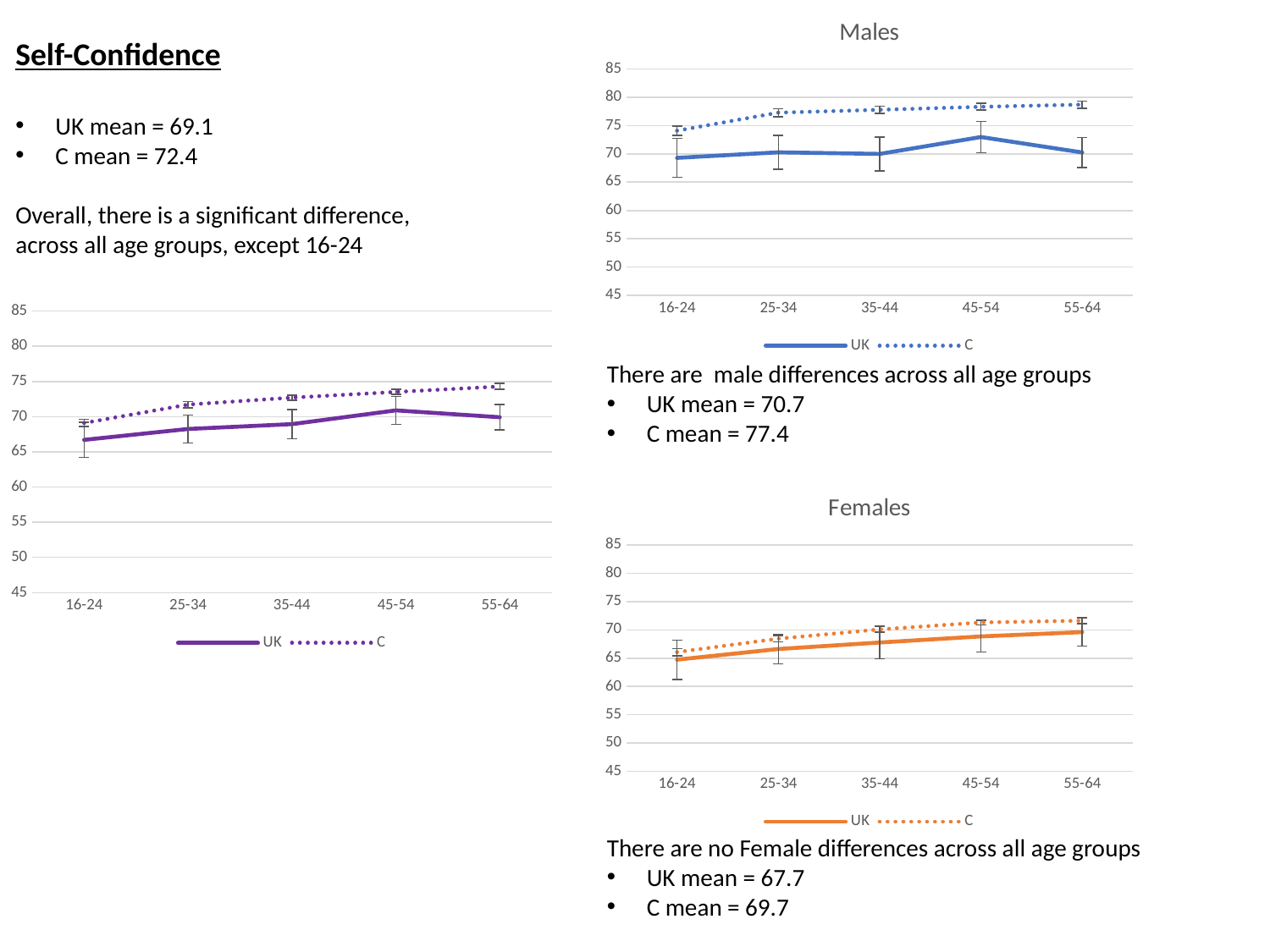
In the chart on the left of the slide, which series has the larger value at 16-24, UK or C? C In the chart titled "Males", which series is drawn with a dotted line? C In the chart titled "Females", does the C series rise or fall from 16-24 to 55-64? rise In the chart titled "Males", is the value for the C series at 55-64 greater or less than 75? greater In the chart on the left of the slide, which age group has the highest value for the UK series? 45-54 How many series does the legend of the chart on the left of the slide list? 2 How many age-group categories are shown on the x axis of the chart titled "Females"? 5 In the chart titled "Females", is the value for the UK series at 16-24 greater or less than 70? less In the chart titled "Males", which age group has the highest value for the UK series? 45-54 In the chart titled "Males", is the value for the UK series at 45-54 greater or less than 70? greater What kind of chart is the chart titled "Males"? line chart